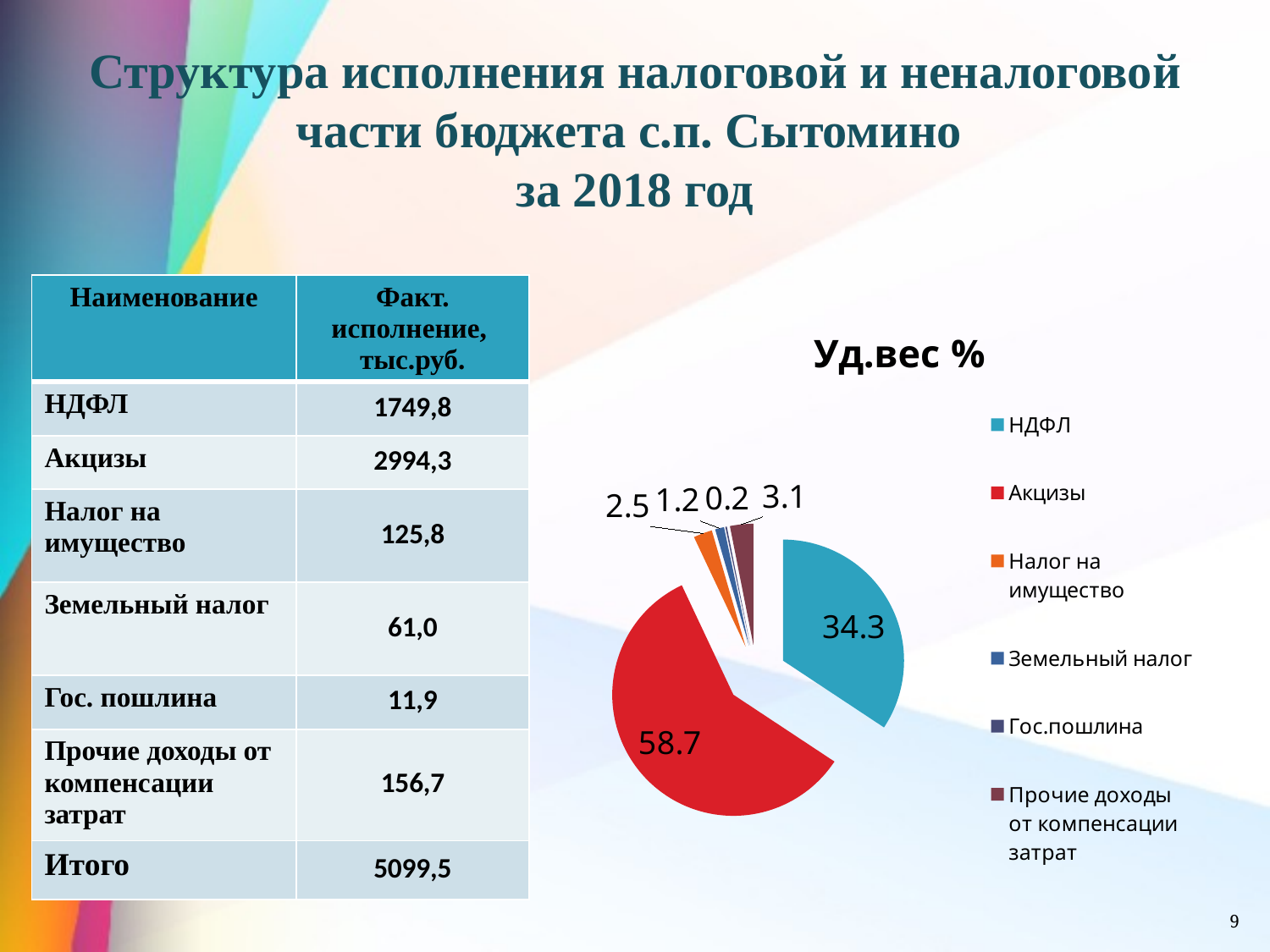
What kind of chart is shown on the slide? pie chart Which is larger in the pie chart, Земельный налог or Прочие доходы от компенсации затрат? Прочие доходы от компенсации затрат Which category has the largest slice in the pie chart? Акцизы What is the title of the pie chart? Уд.вес % What is the value shown for Акцизы in the pie chart? 58.7 What is the value shown for Налог на имущество in the pie chart? 2.5 Which category has the smallest slice in the pie chart? Гос.пошлина What is the difference between the values for Акцизы and НДФЛ in the pie chart? 24.4 What is the value shown for Гос.пошлина in the pie chart? 0.2 How many categories does the legend of the pie chart list? 6 What is the value shown for Прочие доходы от компенсации затрат in the pie chart? 3.1 What is the value shown for НДФЛ in the pie chart? 34.3